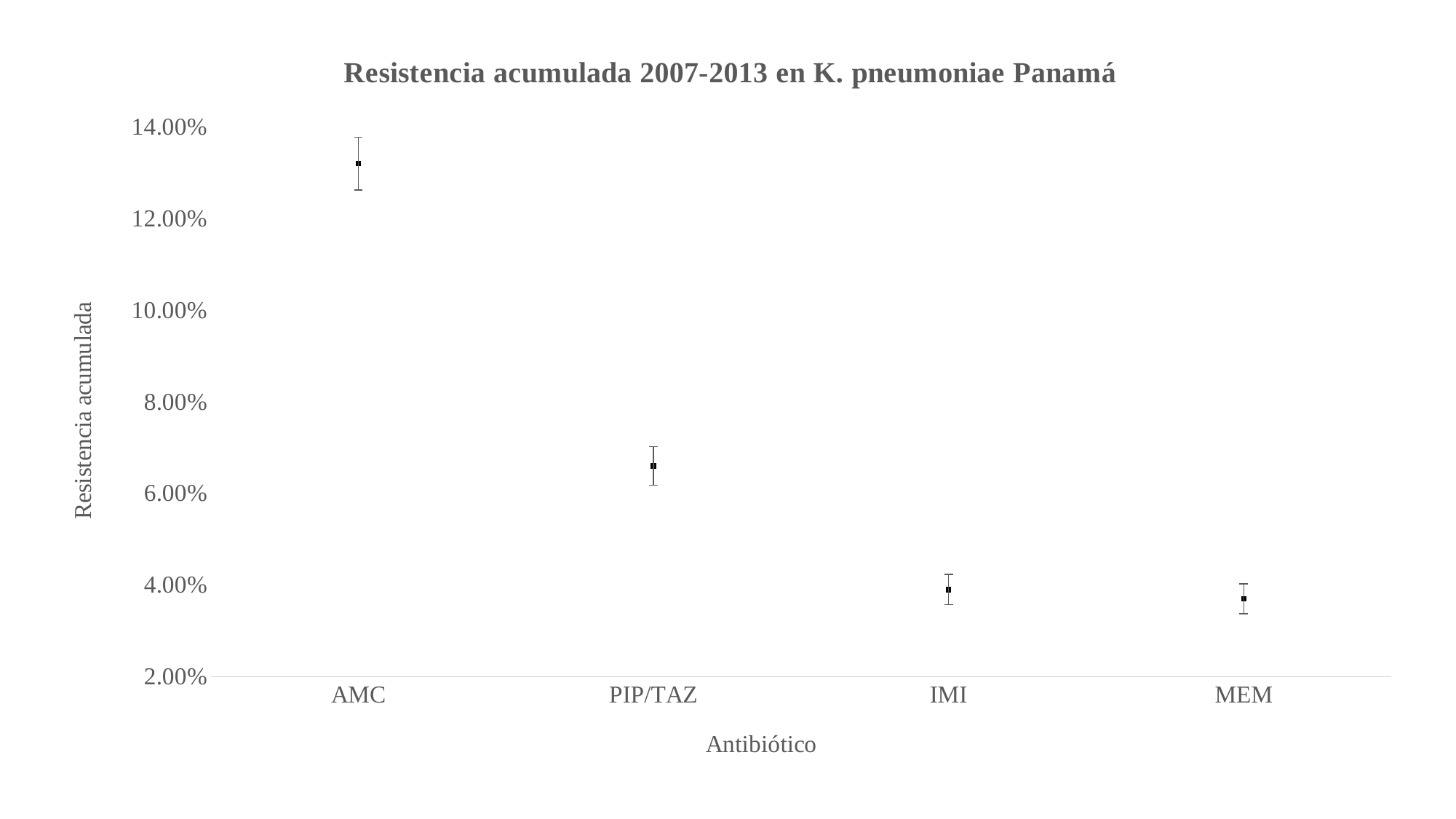
How many antibiotics are plotted on the x axis? 4 Which antibiotic has the highest cumulative resistance? AMC Do the values rise or fall moving from AMC to MEM along the x axis? fall Is the value for MEM greater or less than 6.00%? less Is the value for AMC greater or less than 12.00%? greater What is the title of the chart? Resistencia acumulada 2007-2013 en K. pneumoniae Panamá What is the label of the x axis? Antibiótico Which has a higher cumulative resistance, AMC or PIP/TAZ? AMC Is the value for IMI greater or less than 6.00%? less What kind of chart is shown on the slide? Scatter (point) chart with error bars